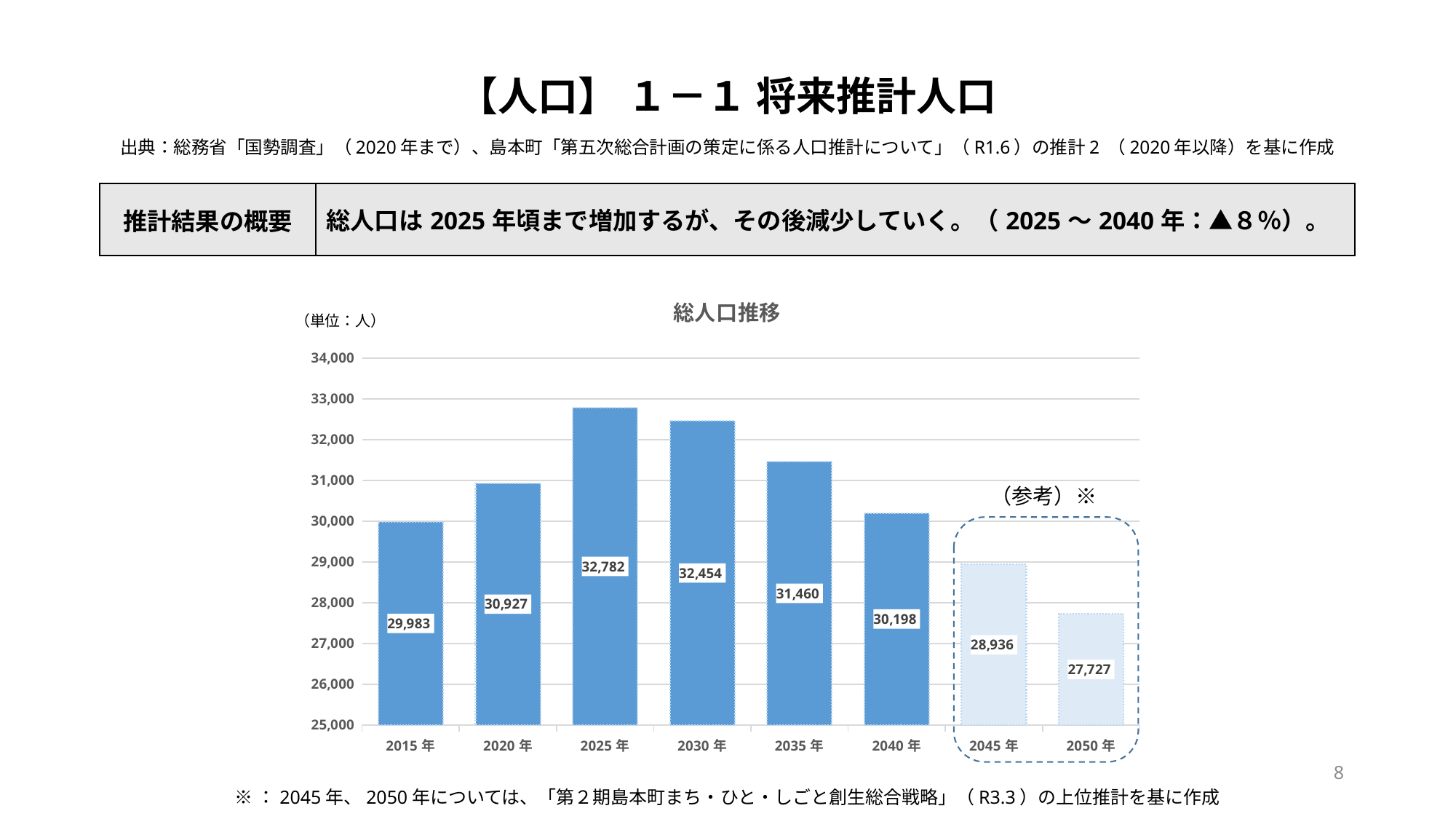
Is the value for 2045年 in the 総人口推移 chart greater or less than 29,000? less Which year has the highest value in the 総人口推移 chart? 2025年 How many years are shown on the x axis of the 総人口推移 chart? 8 What is the value for 2015年 in the 総人口推移 chart? 29,983 Do the values in the 総人口推移 chart rise or fall from 2025年 to 2050年? fall What is the value for 2025年 in the 総人口推移 chart? 32,782 What kind of chart is the 総人口推移 chart? bar chart What is the difference between the values for 2025年 and 2040年 in the 総人口推移 chart? 2,584 Which year has the lowest value in the 総人口推移 chart? 2050年 What is the value for 2050年 in the 総人口推移 chart? 27,727 What is the title of the chart on the slide? 総人口推移 Which is larger in the 総人口推移 chart, the value for 2020年 or the value for 2035年? 2035年